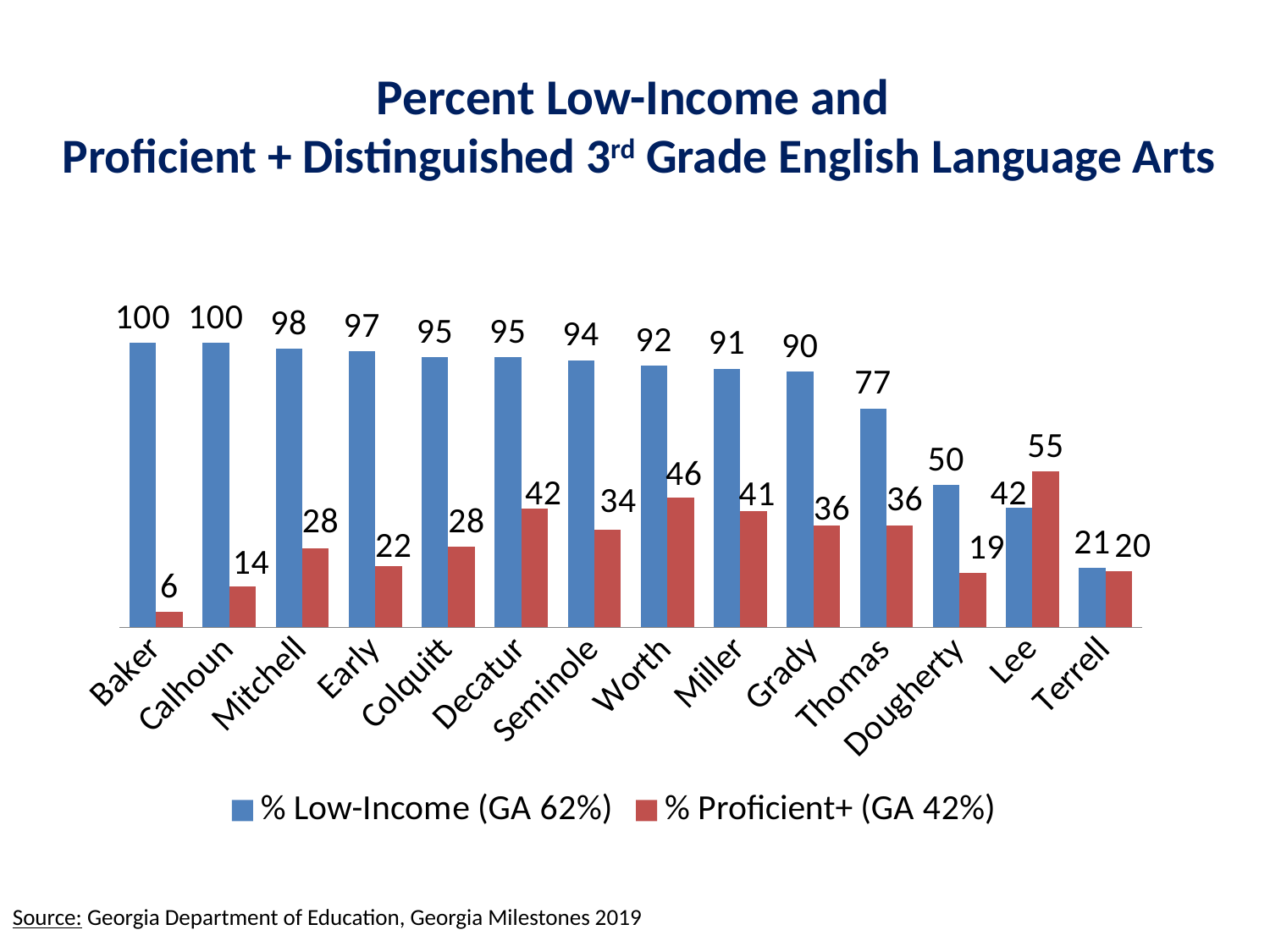
What is the % Proficient+ value for Baker? 6 How many series does the legend list? 2 What is the % Low-Income value for Thomas? 77 What is the % Proficient+ value for Worth? 46 What Georgia statewide value is given in the legend for % Proficient+? 42% How many counties are shown on the x axis? 14 What kind of chart is shown on the slide? Bar chart Which county has the highest % Proficient+ value? Lee Which is larger for Lee: the % Low-Income value or the % Proficient+ value? % Proficient+ What is the difference between the % Low-Income and % Proficient+ values for Calhoun? 86 Which county has the lowest % Low-Income value? Terrell Do the % Low-Income values rise or fall from Baker to Terrell along the x axis? Fall